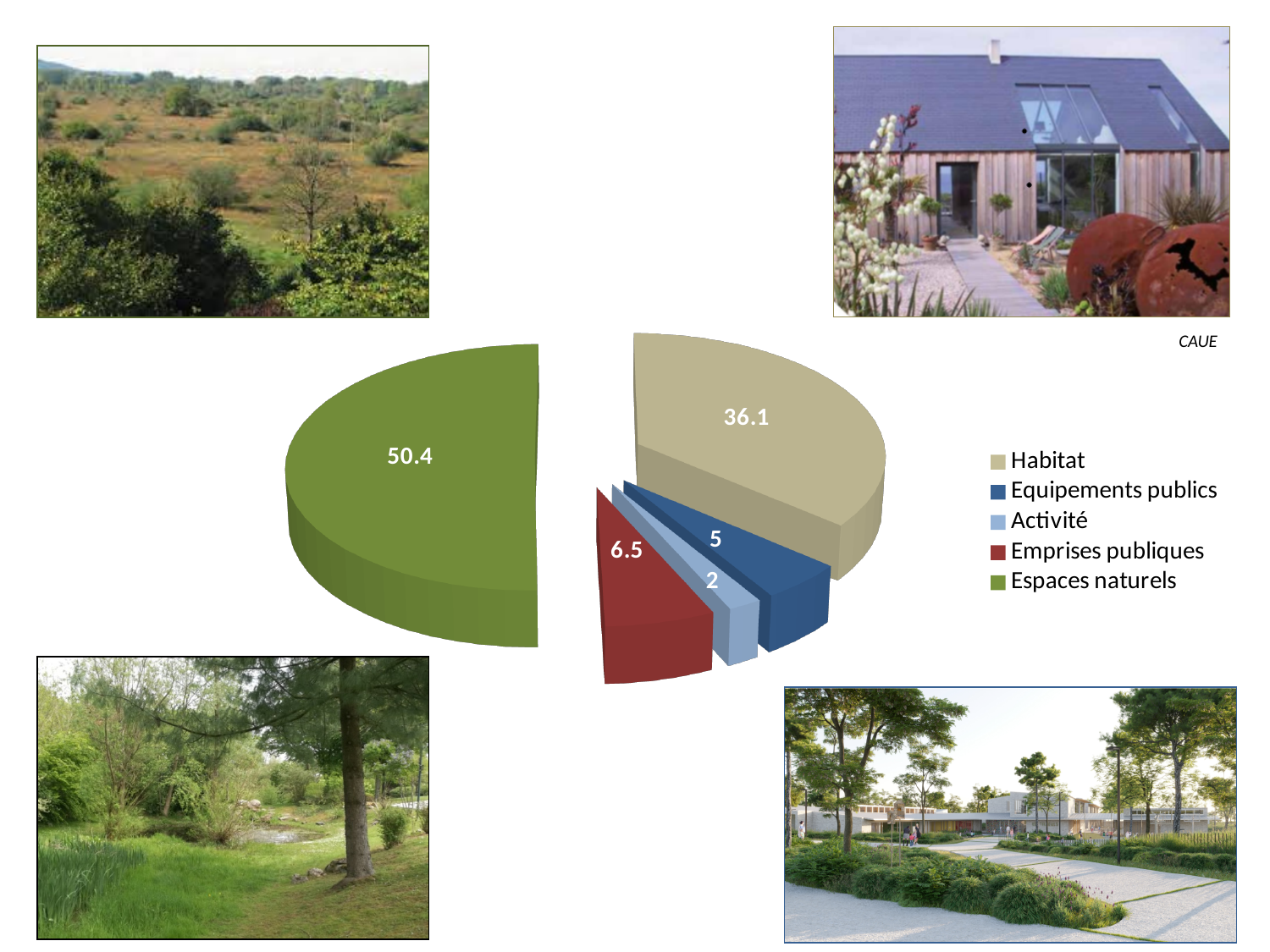
What is the difference between the Espaces naturels value and the Habitat value in the pie chart? 14.3 What value is shown for the Activité slice of the pie chart? 2 What value is shown for the Habitat slice of the pie chart? 36.1 What kind of chart is shown on the slide? Pie chart What value is shown for the Emprises publiques slice of the pie chart? 6.5 Which category has the largest slice in the pie chart? Espaces naturels What colour is the Espaces naturels slice in the pie chart? Green Which is larger in the pie chart, Emprises publiques or Equipements publics? Emprises publiques Which category has the smallest slice in the pie chart? Activité What value is shown for the Equipements publics slice of the pie chart? 5 What value is shown for the Espaces naturels slice of the pie chart? 50.4 How many categories does the legend of the pie chart list? 5